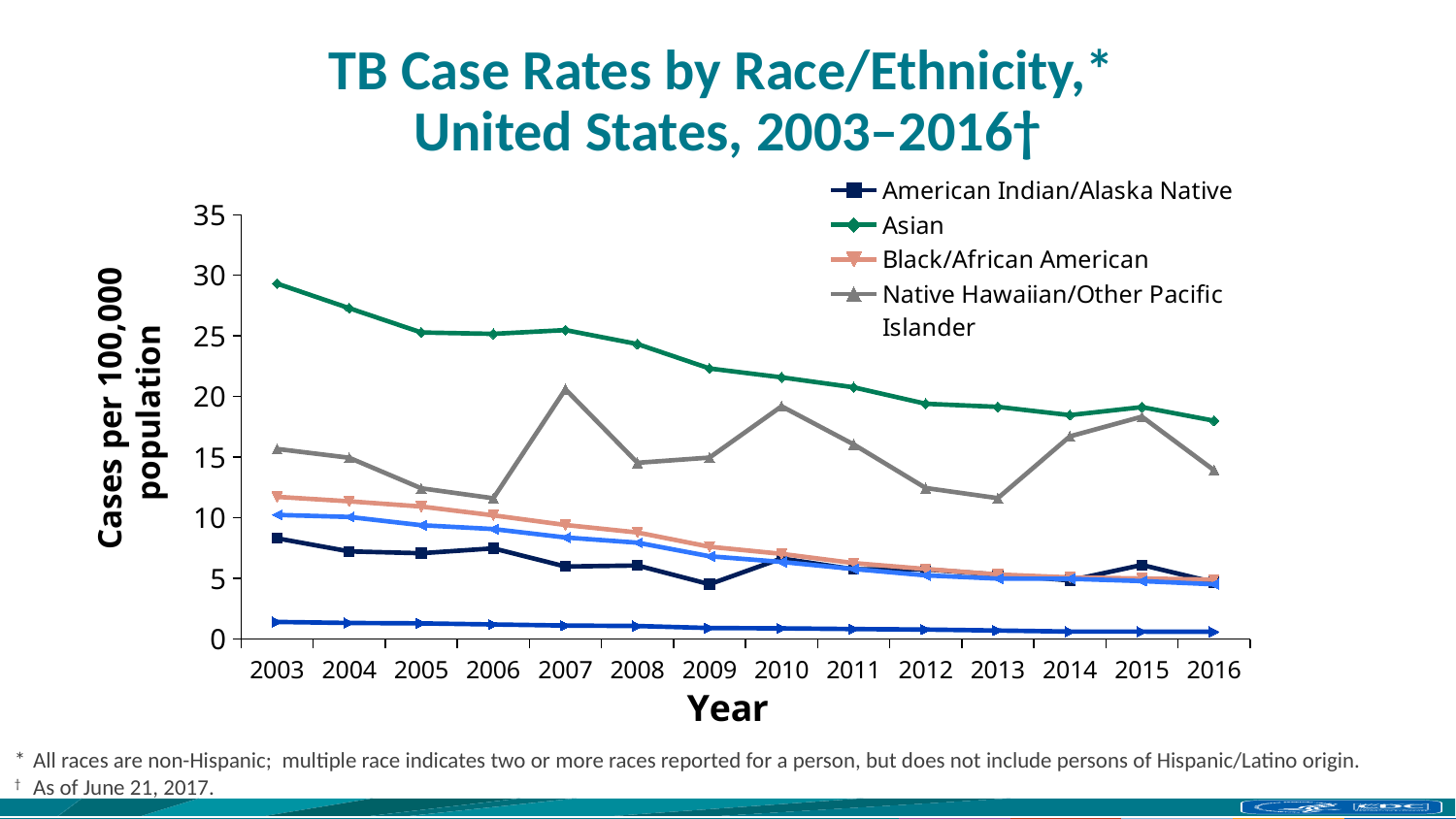
Is the value for Asian in 2016 greater or less than 20? less What kind of chart is shown on the slide? line chart How many years are plotted along the x axis? 14 Does the TB case rate for Asian rise or fall from 2003 to 2016? fall What is the label of the y axis? Cases per 100,000 population How many series are listed in the legend? 4 In 2007, which is larger: the value for Native Hawaiian/Other Pacific Islander or the value for Black/African American? Native Hawaiian/Other Pacific Islander Which race/ethnicity has the highest TB case rate in 2003? Asian Is the value for Black/African American in 2003 greater or less than 10? greater Is the value for American Indian/Alaska Native in 2003 greater or less than 5? greater What is the title of the chart? TB Case Rates by Race/Ethnicity, United States, 2003–2016